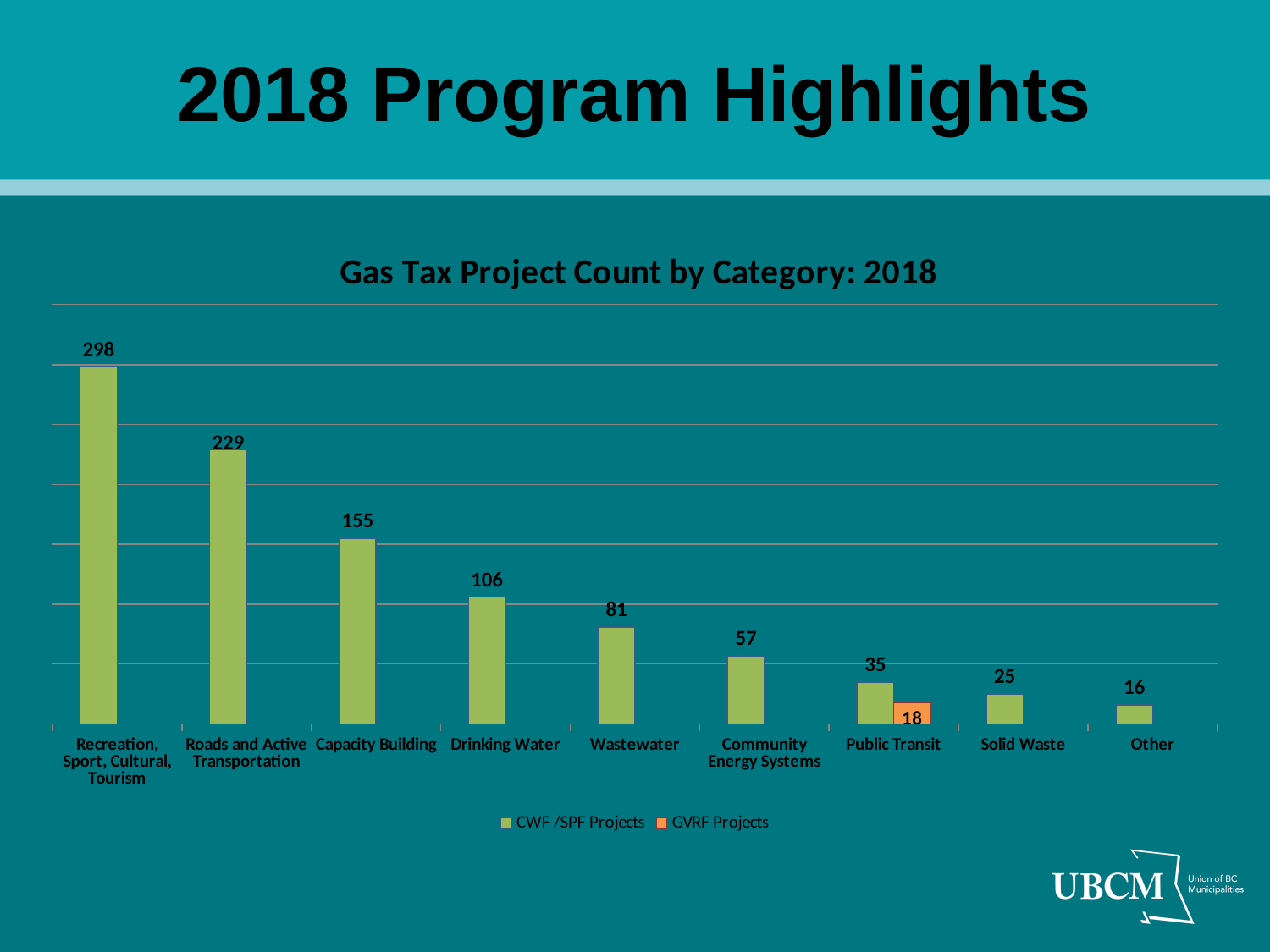
How many CWF /SPF Projects are shown for Drinking Water? 106 How many series does the legend list? 2 Which category has the lowest CWF /SPF Projects count? Other What is the title of the chart? Gas Tax Project Count by Category: 2018 What is the GVRF Projects value for Public Transit? 18 What is the CWF /SPF Projects value for Recreation, Sport, Cultural, Tourism? 298 Which category has the highest CWF /SPF Projects count? Recreation, Sport, Cultural, Tourism What is the difference between the CWF /SPF Projects counts for Roads and Active Transportation and Capacity Building? 74 How many categories are shown on the x axis? 9 Do the CWF /SPF Projects values rise or fall from left to right along the x axis? Fall What kind of chart is shown on the slide? Bar chart Which has more CWF /SPF Projects, Wastewater or Community Energy Systems? Wastewater